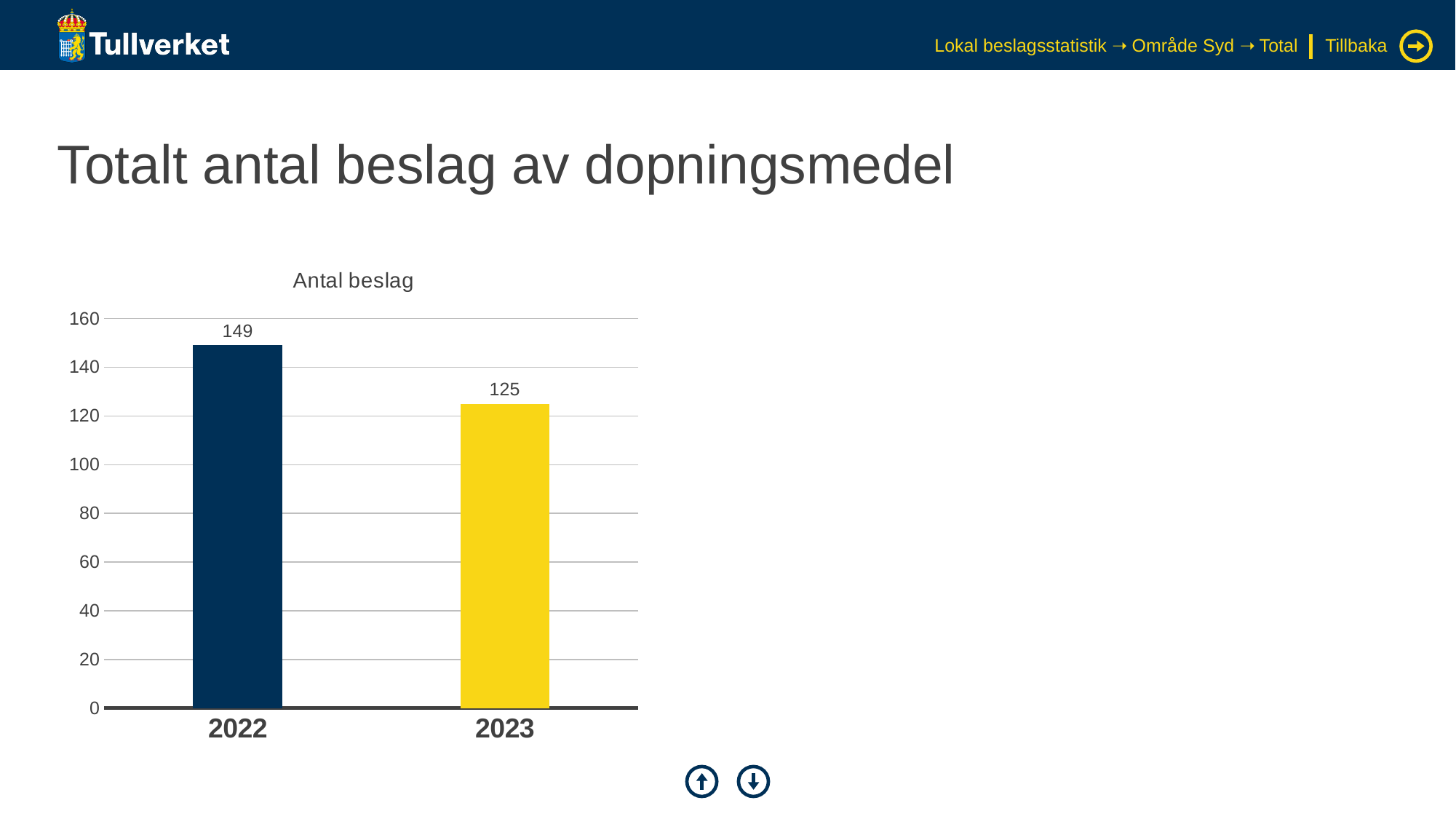
Which year has the lowest number of seizures in the chart? 2023 Is the value for 2023 greater or less than 140? less Which is larger, the value for 2022 or the value for 2023? 2022 What is the value for 2022 in the Antal beslag chart? 149 What kind of chart is shown on the slide? bar chart Which year has the highest number of seizures in the chart? 2022 Do the values rise or fall from 2022 to 2023? fall What is the value for 2023 in the Antal beslag chart? 125 Is the value for 2022 greater or less than 140? greater What is the title of the chart? Antal beslag How many years are shown in the chart? 2 What is the difference between the 2022 and 2023 values? 24